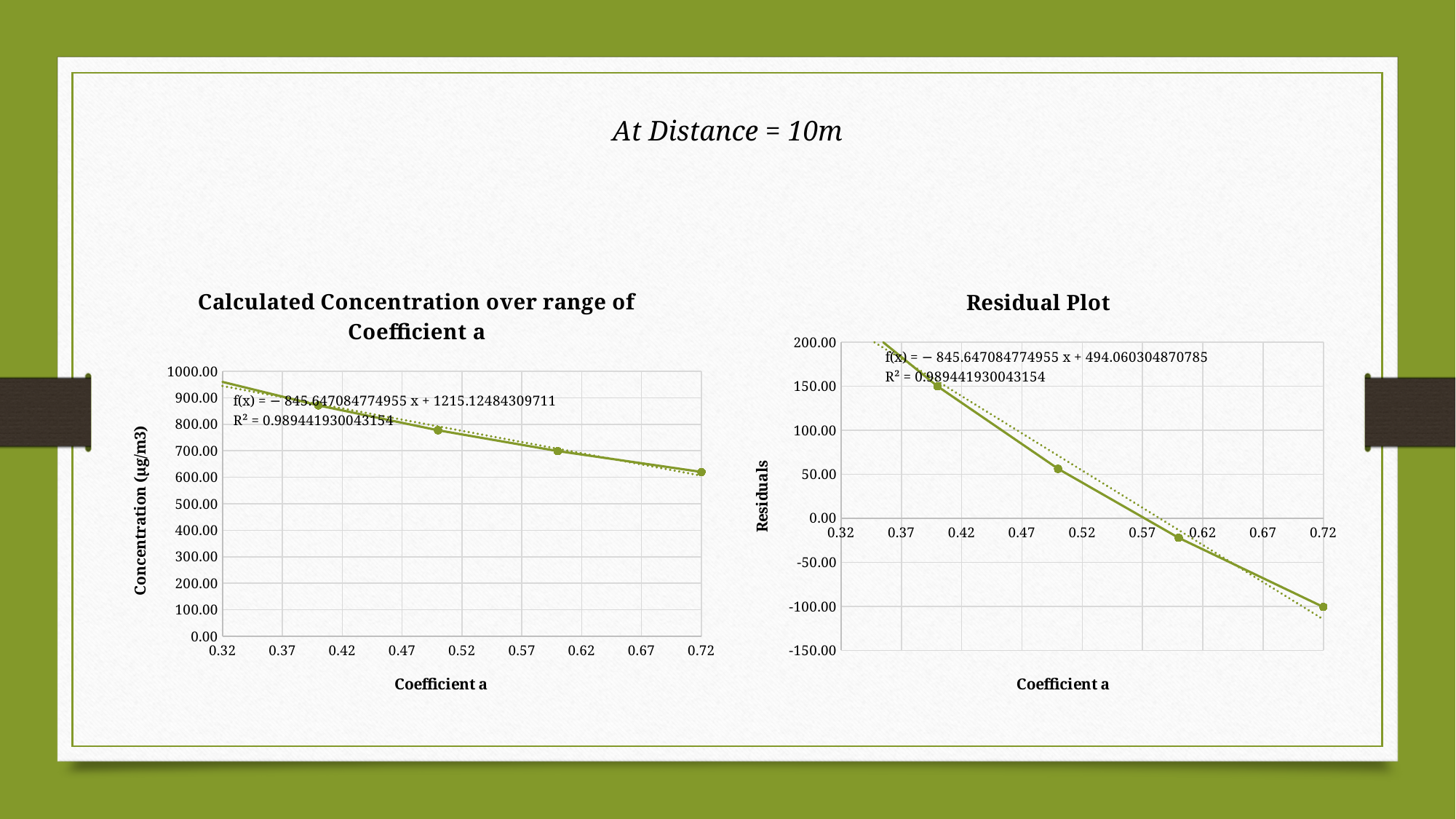
On the 'Calculated Concentration over range of Coefficient a' chart, is the concentration at the leftmost data point greater or less than 800.00? greater What is the R² value shown on the 'Residual Plot' chart? 0.989441930043154 What kind of chart is the 'Calculated Concentration over range of Coefficient a' chart? line chart On the 'Residual Plot' chart, do the residuals rise or fall as Coefficient a increases? fall On the 'Calculated Concentration over range of Coefficient a' chart, do the concentration values rise or fall as Coefficient a increases? fall How many data points are plotted on the 'Calculated Concentration over range of Coefficient a' chart? 5 On the 'Residual Plot' chart, is the residual at the leftmost data point greater or less than 100.00? greater On the 'Residual Plot' chart, which data point has the lowest residual: the one at Coefficient a = 0.72 or the leftmost one? the one at Coefficient a = 0.72 What is the y-axis label of the 'Calculated Concentration over range of Coefficient a' chart? Concentration (µg/m3) On the 'Residual Plot' chart, is the residual at Coefficient a = 0.72 greater or less than -50.00? less